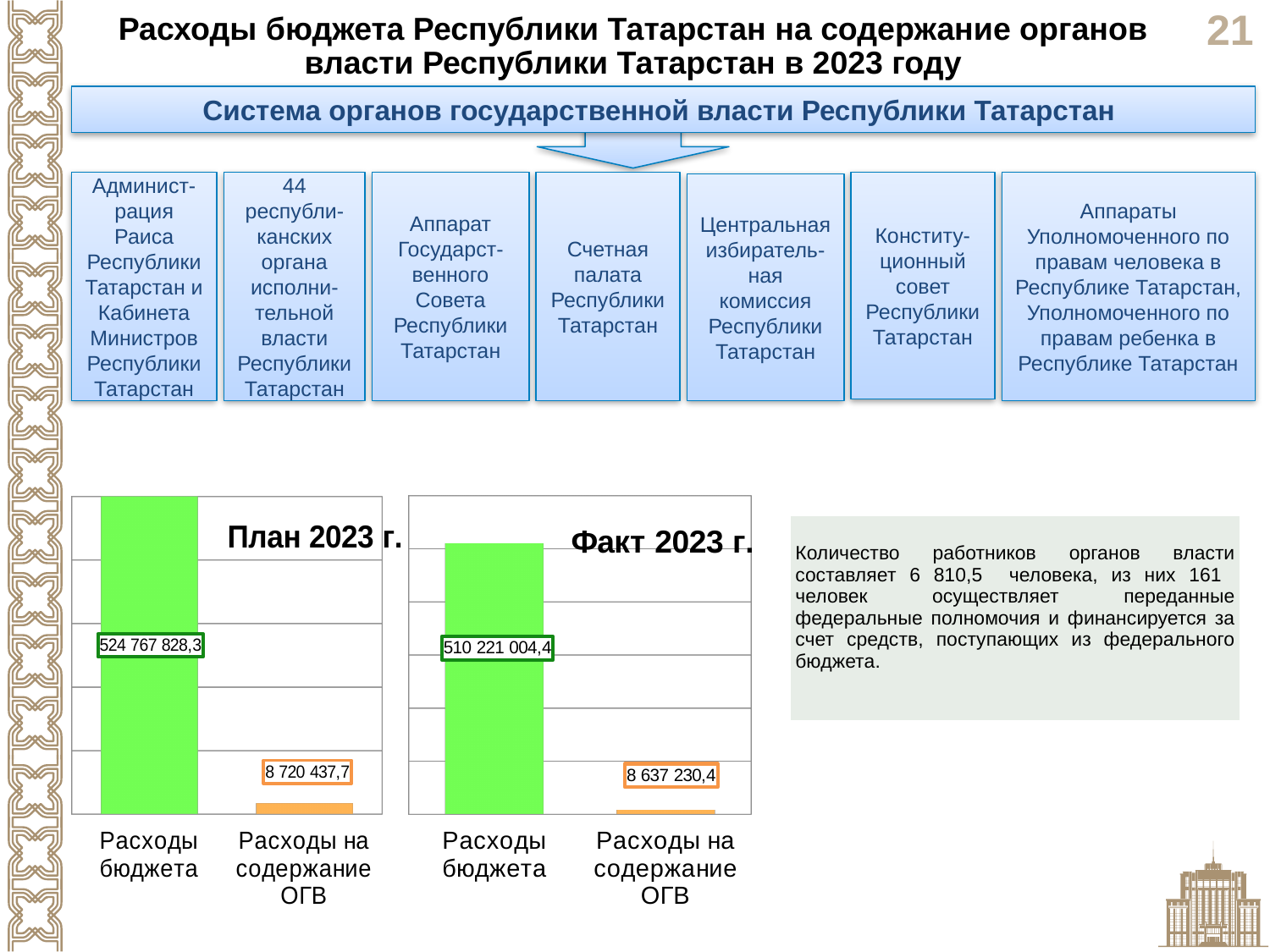
What is the difference between 'Расходы на содержание ОГВ' in the 'План 2023 г.' chart and in the 'Факт 2023 г.' chart? 83 207,3 Which is larger: 'Расходы бюджета' in the 'План 2023 г.' chart or 'Расходы бюджета' in the 'Факт 2023 г.' chart? План 2023 г. In the 'План 2023 г.' chart, what is the value for 'Расходы на содержание ОГВ'? 8 720 437,7 How many categories are shown in the 'Факт 2023 г.' chart? 2 In the 'План 2023 г.' chart, which category has the highest value? Расходы бюджета In the 'Факт 2023 г.' chart, what is the value for 'Расходы бюджета'? 510 221 004,4 In the 'План 2023 г.' chart, what is the value for 'Расходы бюджета'? 524 767 828,3 In the 'Факт 2023 г.' chart, what is the difference between 'Расходы бюджета' and 'Расходы на содержание ОГВ'? 501 583 774,0 What type of chart is the 'План 2023 г.' chart? Bar chart In the 'Факт 2023 г.' chart, which category has the lowest value? Расходы на содержание ОГВ In the 'Факт 2023 г.' chart, what is the value for 'Расходы на содержание ОГВ'? 8 637 230,4 In the 'План 2023 г.' chart, what is the difference between 'Расходы бюджета' and 'Расходы на содержание ОГВ'? 516 047 390,6